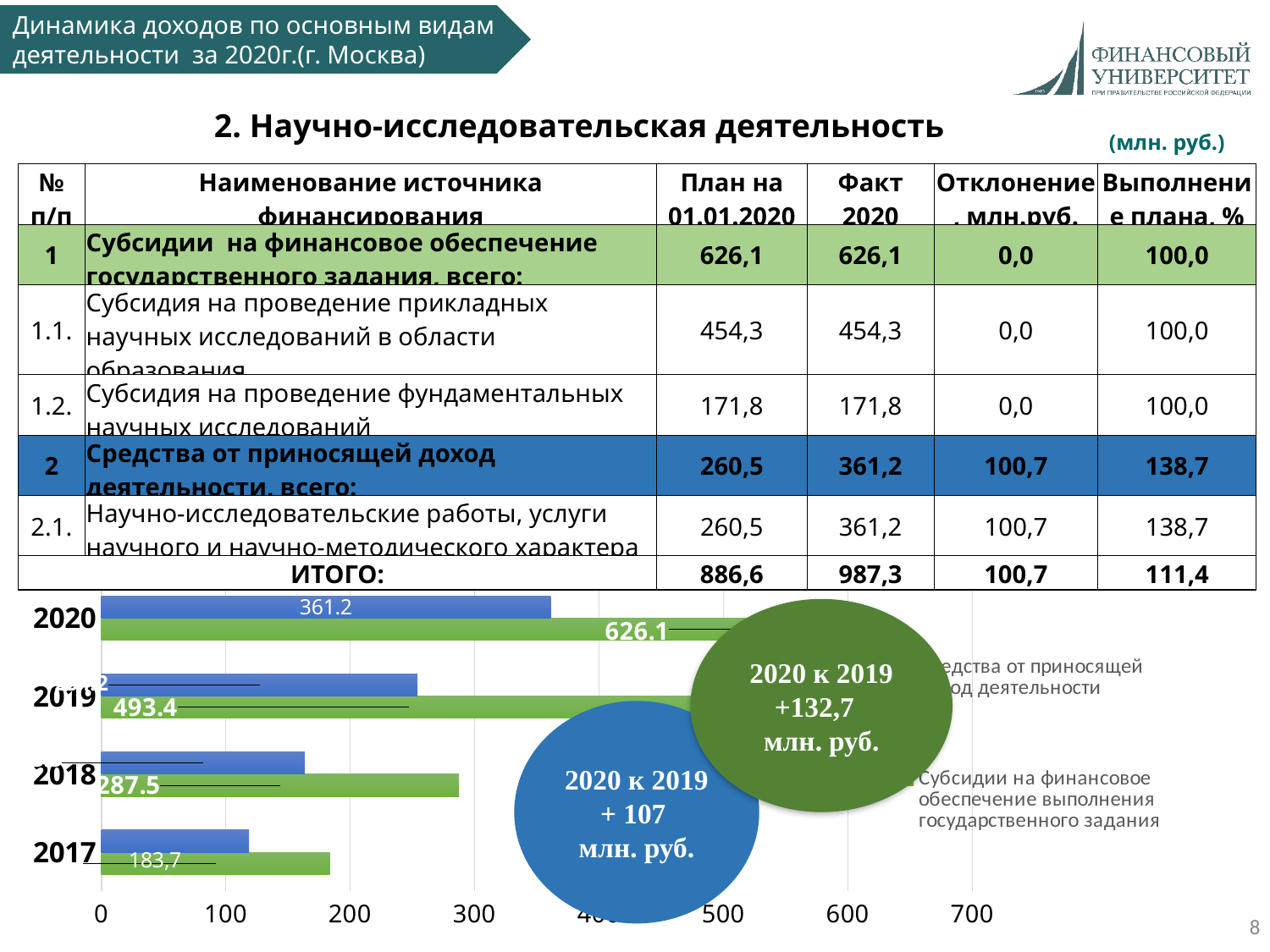
On the bar chart, which year has the lowest green bar (Субсидии)? 2017 On the bar chart, what is the value of the green bar for 2017? 183,7 On the bar chart, what is the value of the green bar for 2018? 287.5 On the bar chart, what is the value of the blue bar for 2020? 361.2 On the bar chart, what is the value of the green bar for 2019? 493.4 On the bar chart, what is the difference between the green bar and the blue bar for 2020? 264.9 On the bar chart, which year has the highest green bar (Субсидии)? 2020 How many series does the bar chart's legend list? 2 What kind of chart is shown at the bottom of the slide? bar chart On the bar chart, do the green bars (Субсидии) rise or fall from 2017 to 2020? rise On the bar chart, what is the value of the green bar (Субсидии на финансовое обеспечение выполнения государственного задания) for 2020? 626.1 How many years are shown on the bar chart? 4